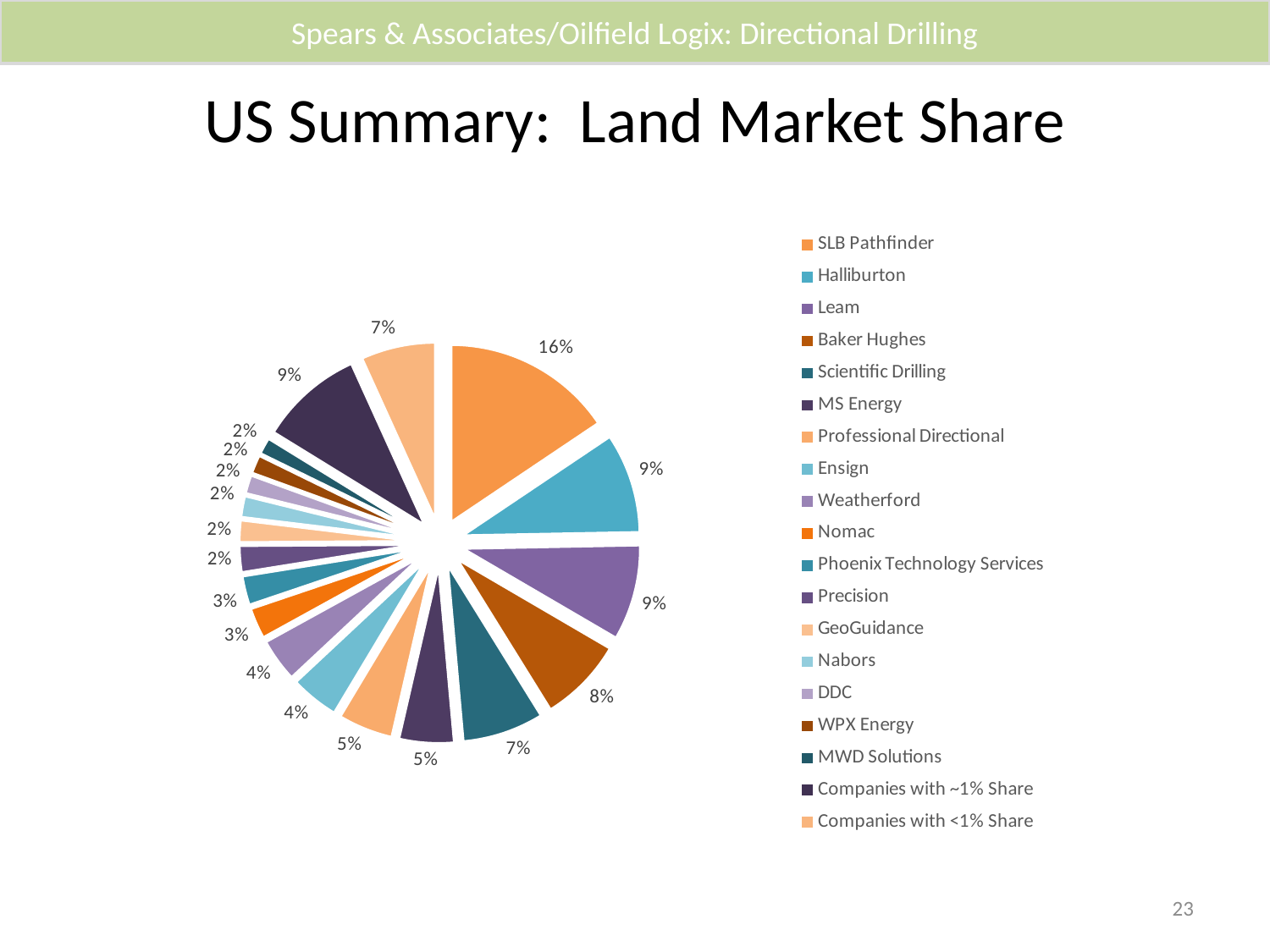
What is the title of the slide? US Summary: Land Market Share What share of the pie does Ensign hold? 4% What kind of chart is shown on the slide? Pie chart Which company has the largest slice of the pie? SLB Pathfinder What share of the pie does Baker Hughes hold? 8% What share of the pie is labelled for Companies with ~1% Share? 9% What share of the pie does Scientific Drilling hold? 7% How many percentage points larger is SLB Pathfinder's share than Baker Hughes' share? 8 percentage points Which has the larger share, Scientific Drilling or MS Energy? Scientific Drilling What share of the pie does Halliburton hold? 9% What share of the pie does SLB Pathfinder hold? 16% How many entries does the legend list? 19